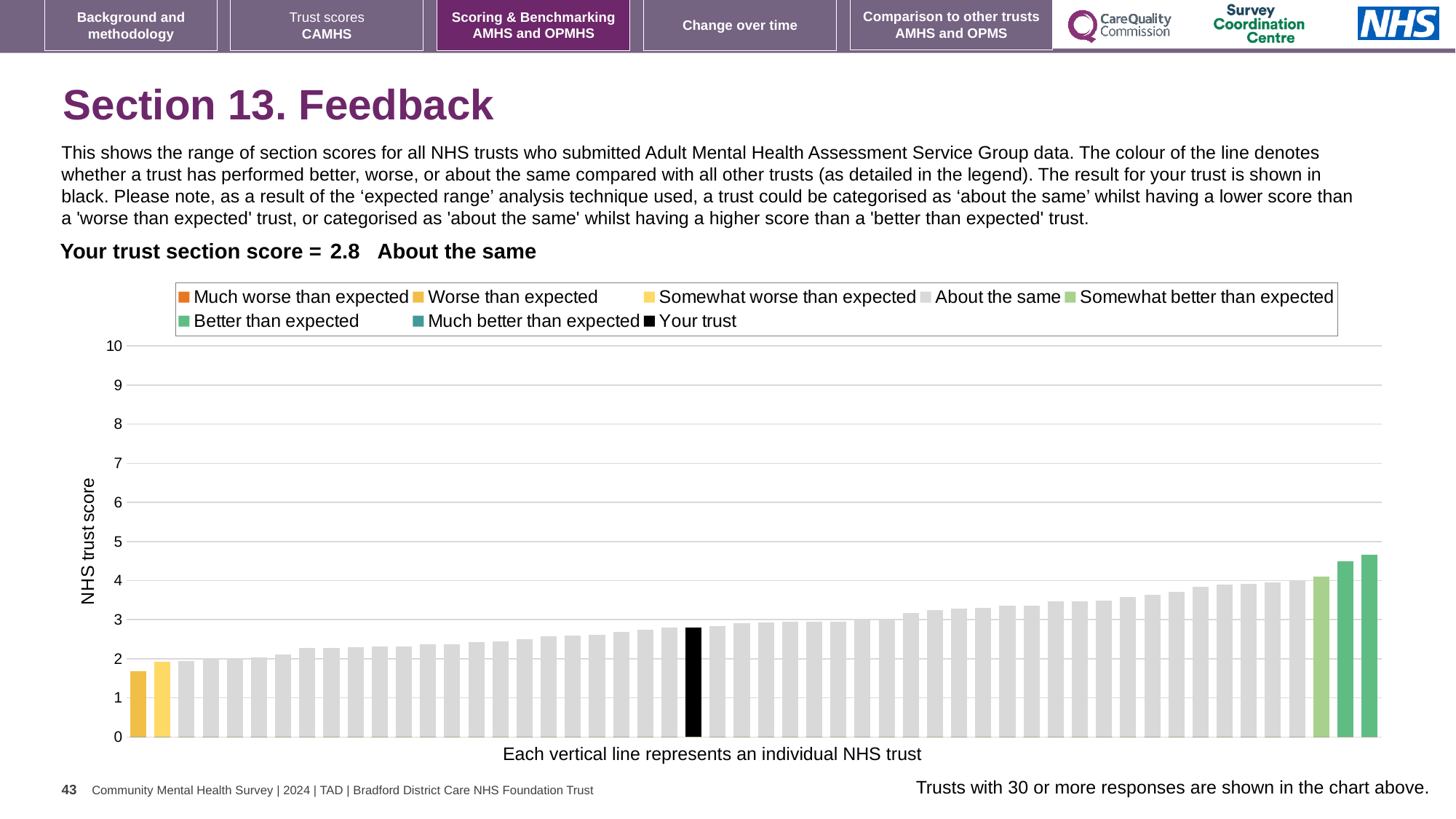
How many entries does the chart legend list? 8 Do the bar values rise or fall from left to right along the x axis? rise What kind of chart is shown on the slide? bar chart Is the value for the tallest bar (rightmost) greater or less than 4? greater Is the value for your trust (the black bar) greater or less than 3? less Is the value for the leftmost bar greater or less than 1? greater What is the label on the y axis of the chart? NHS trust score What is the section score for your trust shown on the slide? 2.8 What colour is the bar representing your trust in the chart? black Which performance category is your trust placed in for Section 13. Feedback? About the same